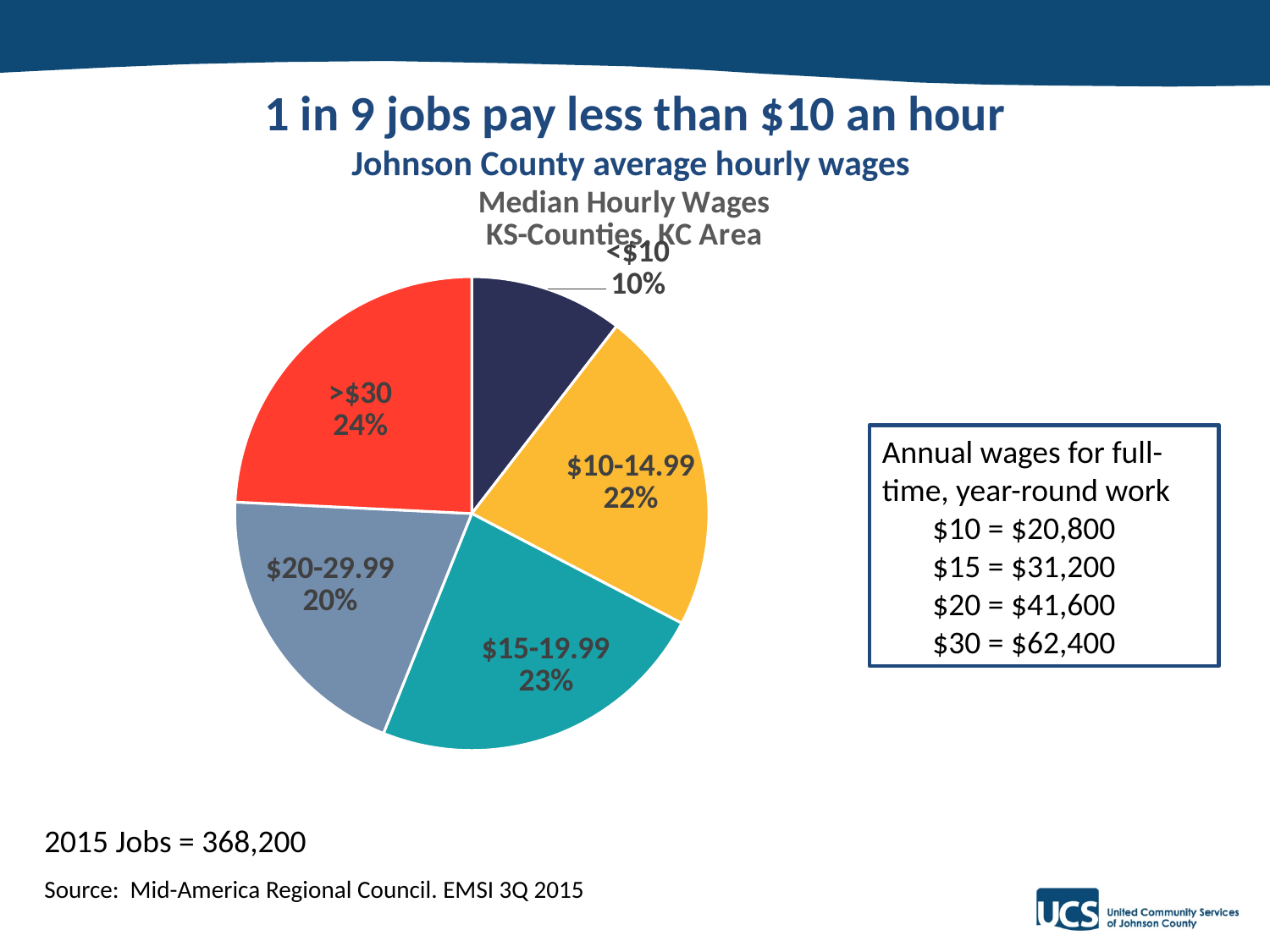
How many wage categories are shown in the pie chart? 5 What is the title printed on the chart itself? Median Hourly Wages KS-Counties, KC Area What share of jobs pay less than $10 an hour? 10% What is the difference in percentage points between the >$30 slice and the <$10 slice? 14 percentage points What percentage of jobs fall in the $15-19.99 wage range? 23% What percentage of jobs fall in the $20-29.99 wage range? 20% What type of chart is shown on the slide? pie chart What share of jobs pay more than $30 an hour? 24% Which wage category has the largest share of the pie? >$30 What percentage of jobs fall in the $10-14.99 wage range? 22% Which wage category has the smallest share of the pie? <$10 Which slice is larger, $15-19.99 or $20-29.99? $15-19.99